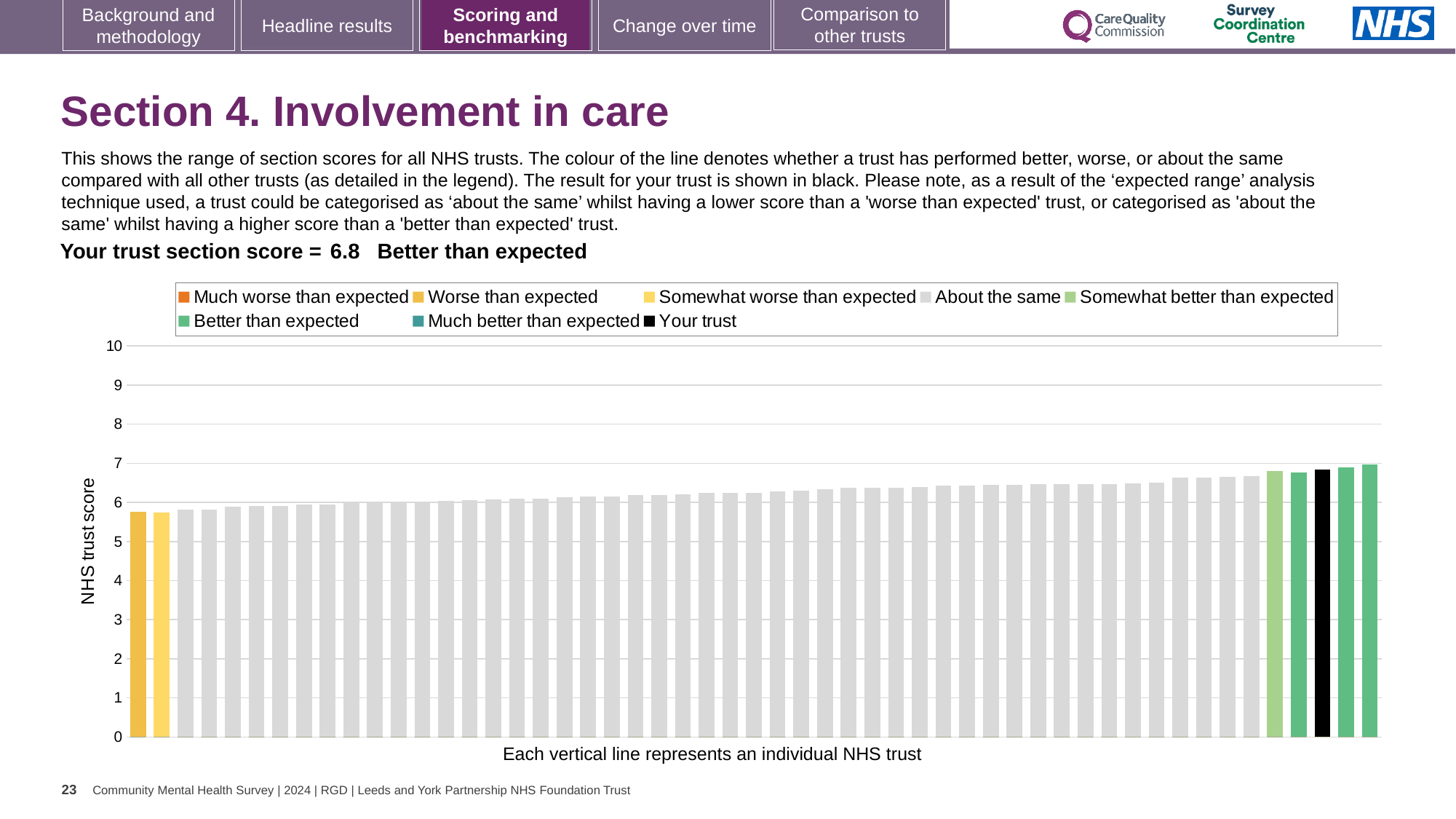
Which performance category is your trust placed in for this section? Better than expected How many entries does the chart legend list? 8 Is the value for your trust greater or less than 6? greater What colour is used for the bar representing your trust? black What is the label on the vertical axis of the chart? NHS trust score How many bars in the chart are coloured black? 1 What is your trust's section score for Involvement in care? 6.8 Is the value for the leftmost bar greater or less than 6? less Do the bar values rise or fall from left to right across the chart? rise Is the value for the leftmost bar greater or less than 5? greater What type of chart is shown on the slide? bar chart Which is higher, the leftmost bar or the rightmost bar? the rightmost bar